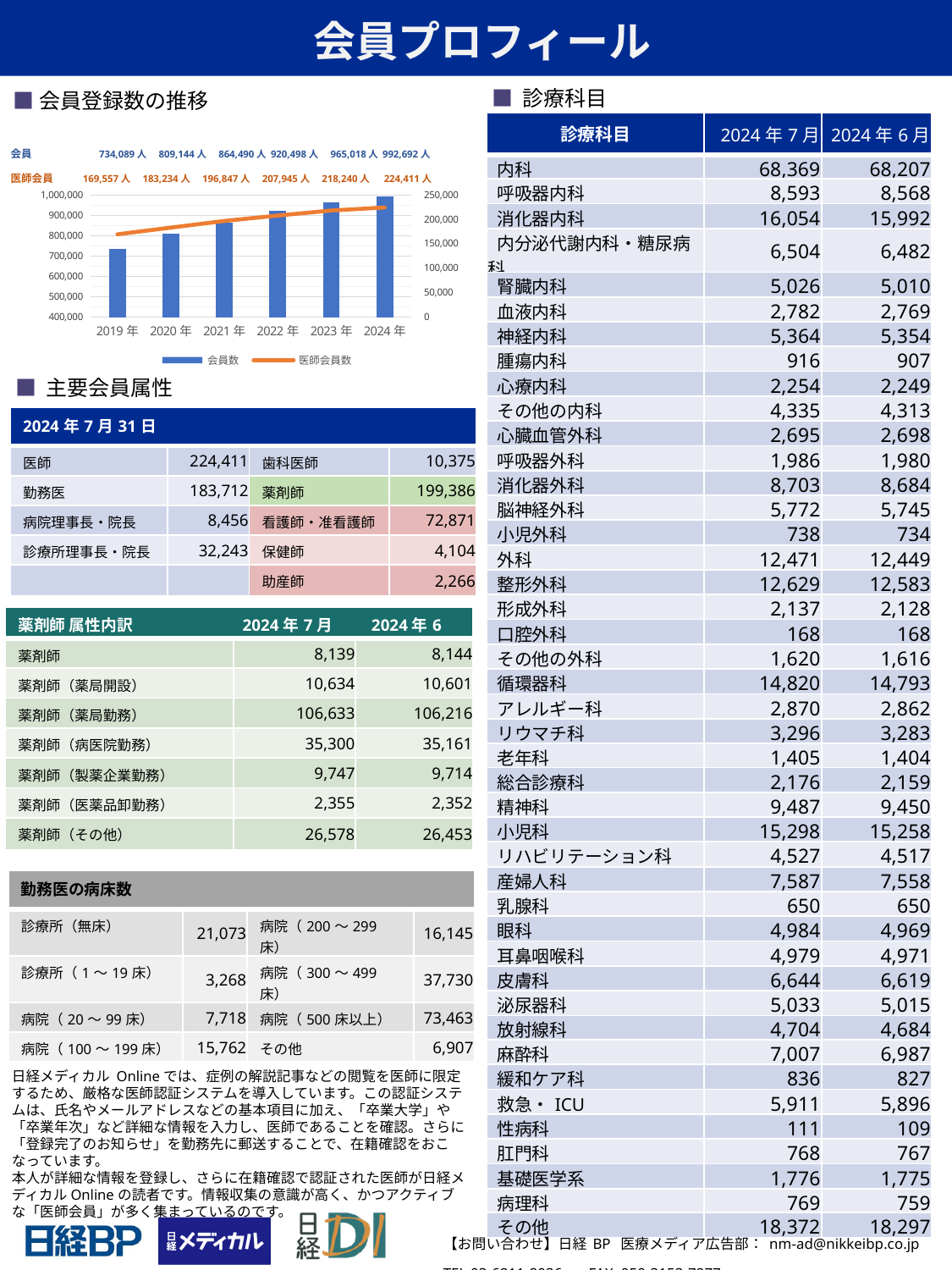
In the 会員登録数の推移 chart, what is the 医師会員 value for 2019年? 169,557人 In the 会員登録数の推移 chart, what is the 会員 value for 2024年? 992,692人 How many series does the legend of the 会員登録数の推移 chart list? 2 In the 会員登録数の推移 chart, what is the 会員 value for 2021年? 864,490人 In the 会員登録数の推移 chart, which year has the highest 会員 value? 2024年 In the 会員登録数の推移 chart, do the 会員 values rise or fall from 2019年 to 2024年? rise In the 会員登録数の推移 chart, what is the difference between the 会員 values for 2024年 and 2019年? 258,603人 In the 会員登録数の推移 chart, what is the difference between the 医師会員 values for 2024年 and 2019年? 54,854人 In the 会員登録数の推移 chart, is the 会員 value for 2020年 greater or less than 800,000? greater In the 会員登録数の推移 chart, what is the 医師会員 value for 2022年? 207,945人 In the 会員登録数の推移 chart, which year has the lowest 医師会員 value? 2019年 How many years are shown on the x axis of the 会員登録数の推移 chart? 6